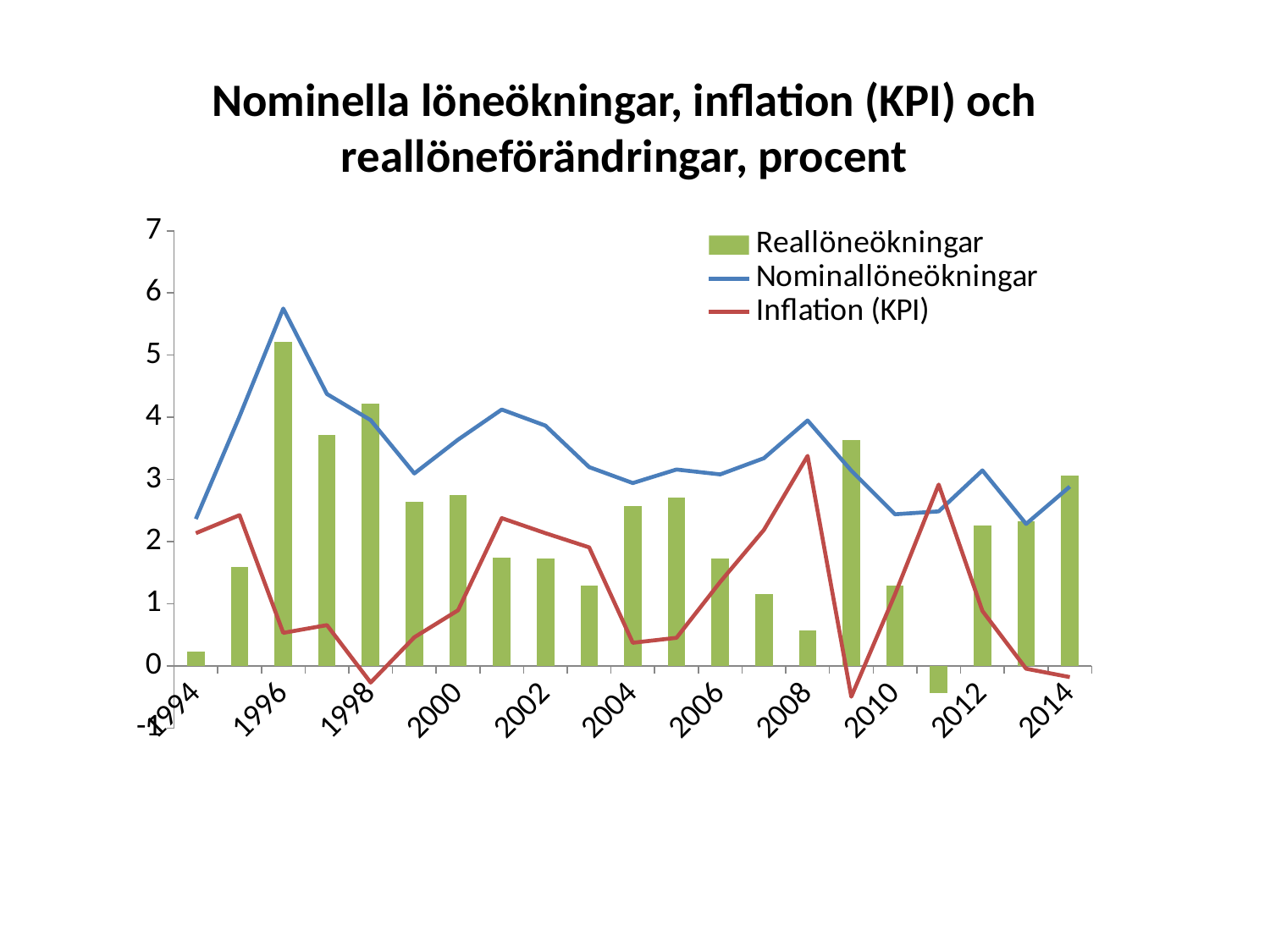
Is the Reallöneökningar value for 1994 greater or less than 1? less In which year is the Reallöneökningar bar highest? 1996 Is the Inflation (KPI) value for 2008 greater or less than 3? greater In which year does the Nominallöneökningar line reach its highest value? 1996 How many years are plotted on the x axis? 21 In which year is the Reallöneökningar bar lowest? 2011 In which year does the Inflation (KPI) line reach its highest value? 2008 How many series does the legend list? 3 Which series is shown with green bars? Reallöneökningar Which is larger, the Reallöneökningar bar for 1996 or for 1997? 1996 Is the Nominallöneökningar value for 1996 greater or less than 5? greater What kind of chart is this? A combined bar and line chart